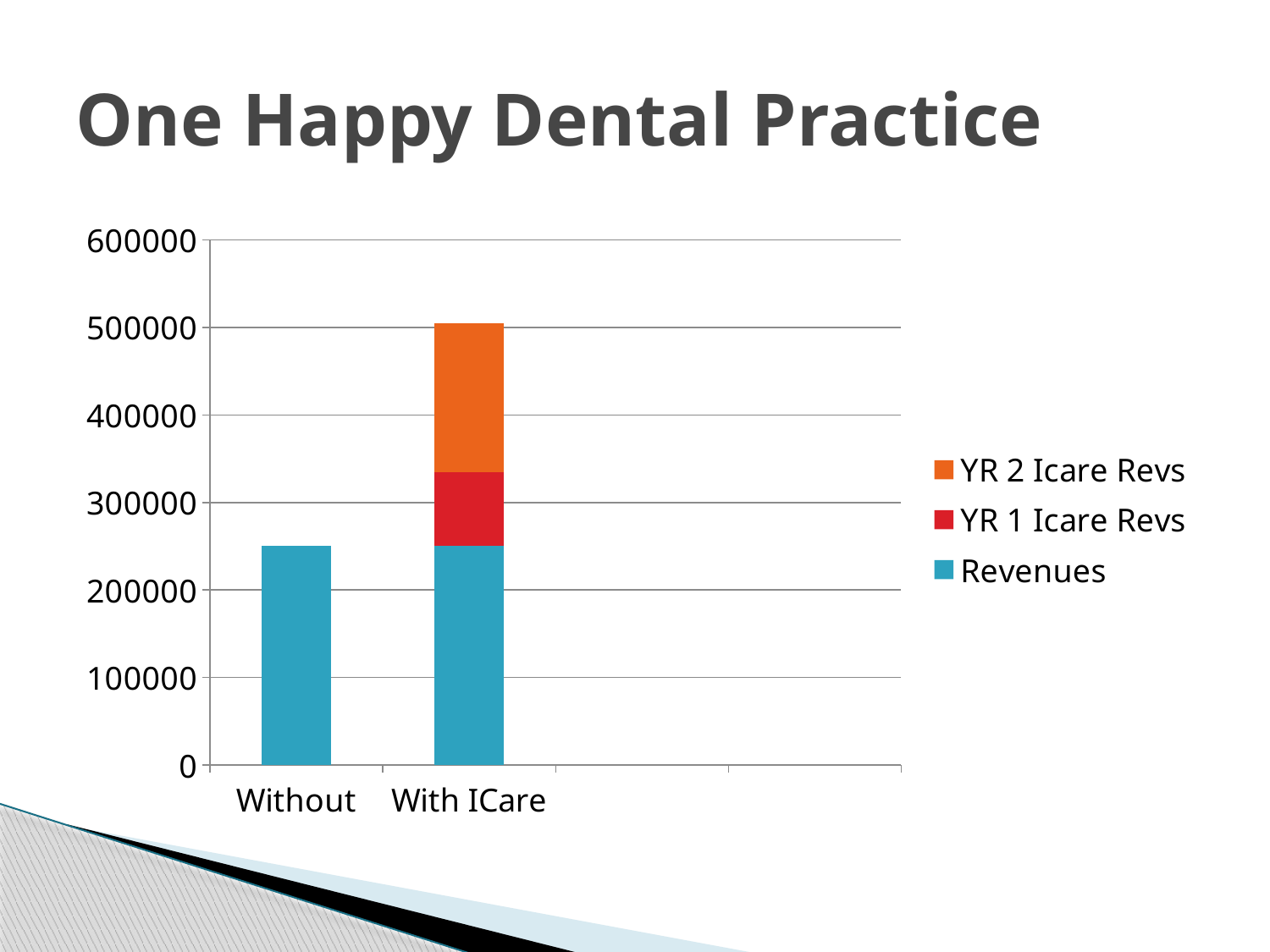
Is the total stacked bar for With ICare greater or less than 400000? greater Is the total stacked bar for With ICare greater or less than 600000? less How many series does the chart's legend list? 3 Which category has the taller stacked bar, Without or With ICare? With ICare What kind of chart is shown on the slide? bar chart What is the title of the slide containing the chart? One Happy Dental Practice Which category has the lowest total bar height? Without How many categories are shown on the x axis of the chart? 2 Is the value for Without greater or less than 300000? less Which series appears only in the With ICare bar and not in the Without bar, besides YR 1 Icare Revs? YR 2 Icare Revs